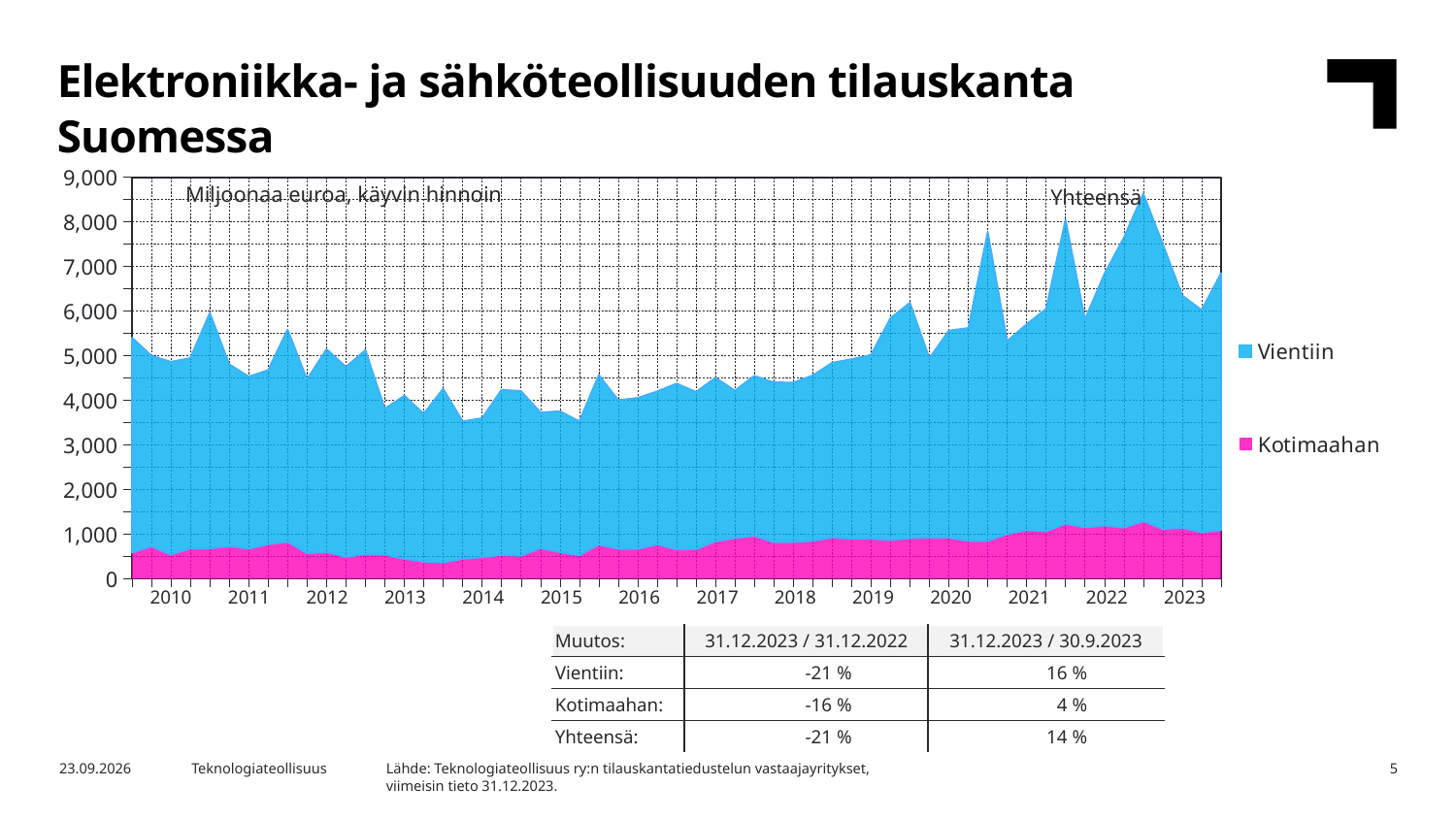
Is the Kotimaahan value in 2023 greater or less than 2,000? less What unit label is shown inside the chart area at the top left? Miljoonaa euroa, käyvin hinnoin Does the total order book generally rise or fall from 2019 to 2022? rise What kind of chart is shown on the slide? area chart In which year does the total (Yhteensä) reach its highest peak? 2022 Which series is larger throughout the chart, Vientiin or Kotimaahan? Vientiin Is the highest total value reached in 2022 greater or less than 8,000? greater How many years are labelled on the x axis? 14 Is the total value during 2014 greater or less than 5,000? less What are the two series named in the chart legend? Vientiin and Kotimaahan How many series does the chart legend list? 2 According to the table below the chart, what is the change in Vientiin for 31.12.2023 / 31.12.2022? -21 %